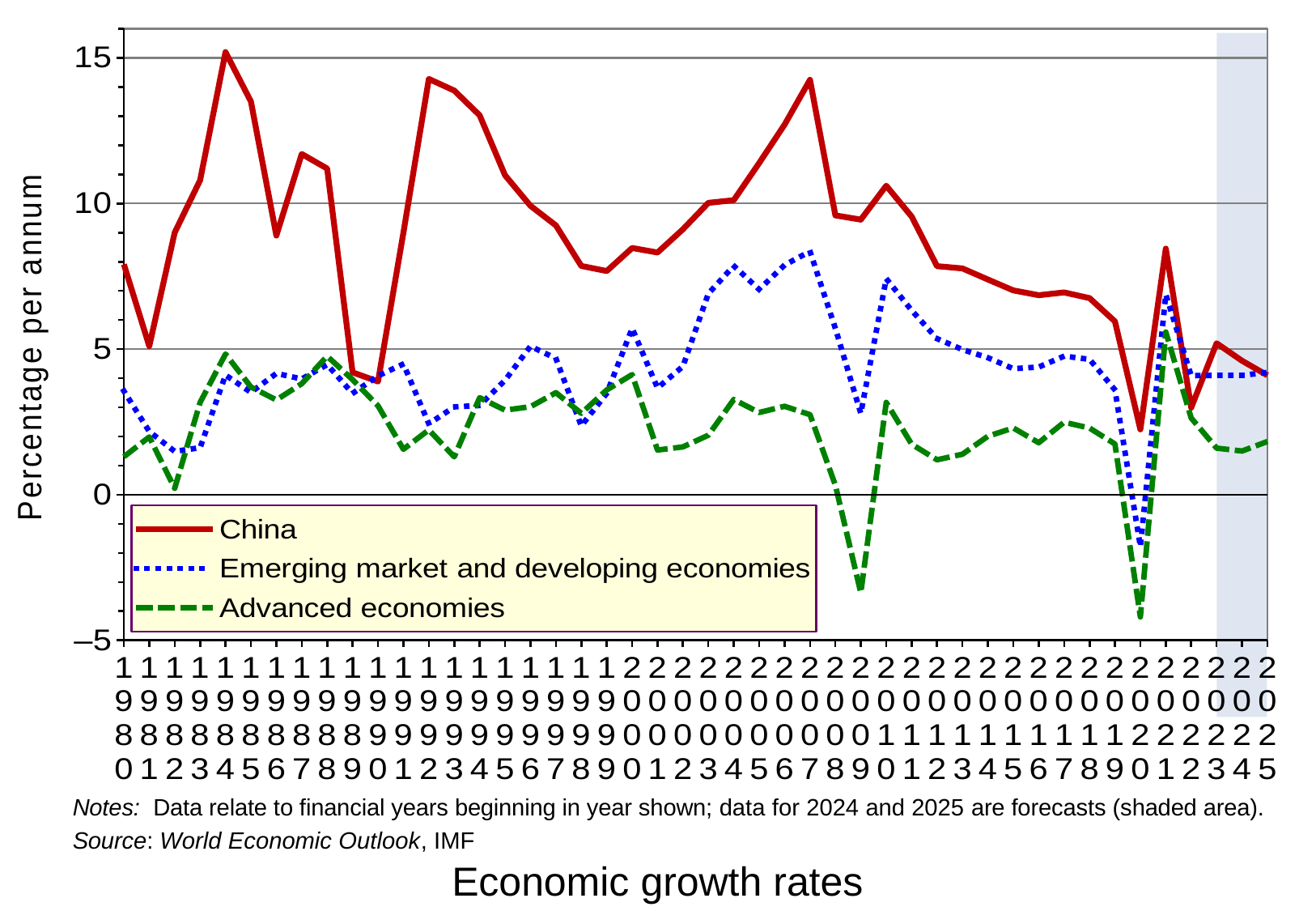
What does the shaded area at the right of the chart represent? forecasts for 2024 and 2025 Is the value for Emerging market and developing economies in 2007 greater or less than 5? greater How many series does the legend list? 3 What is the title of the chart? Economic growth rates Is the value for Advanced economies in 2009 greater or less than 0? less Does the China series rise or fall between 2010 and 2019? fall How many years are plotted along the x axis? 46 In which year does the Advanced economies series reach its lowest value? 2020 Is the value for China in 2020 greater or less than 5? less In 2007, which is larger: the value for China or the value for Advanced economies? China What kind of chart is shown on the slide? line chart In which year does the China series reach its highest value? 1984